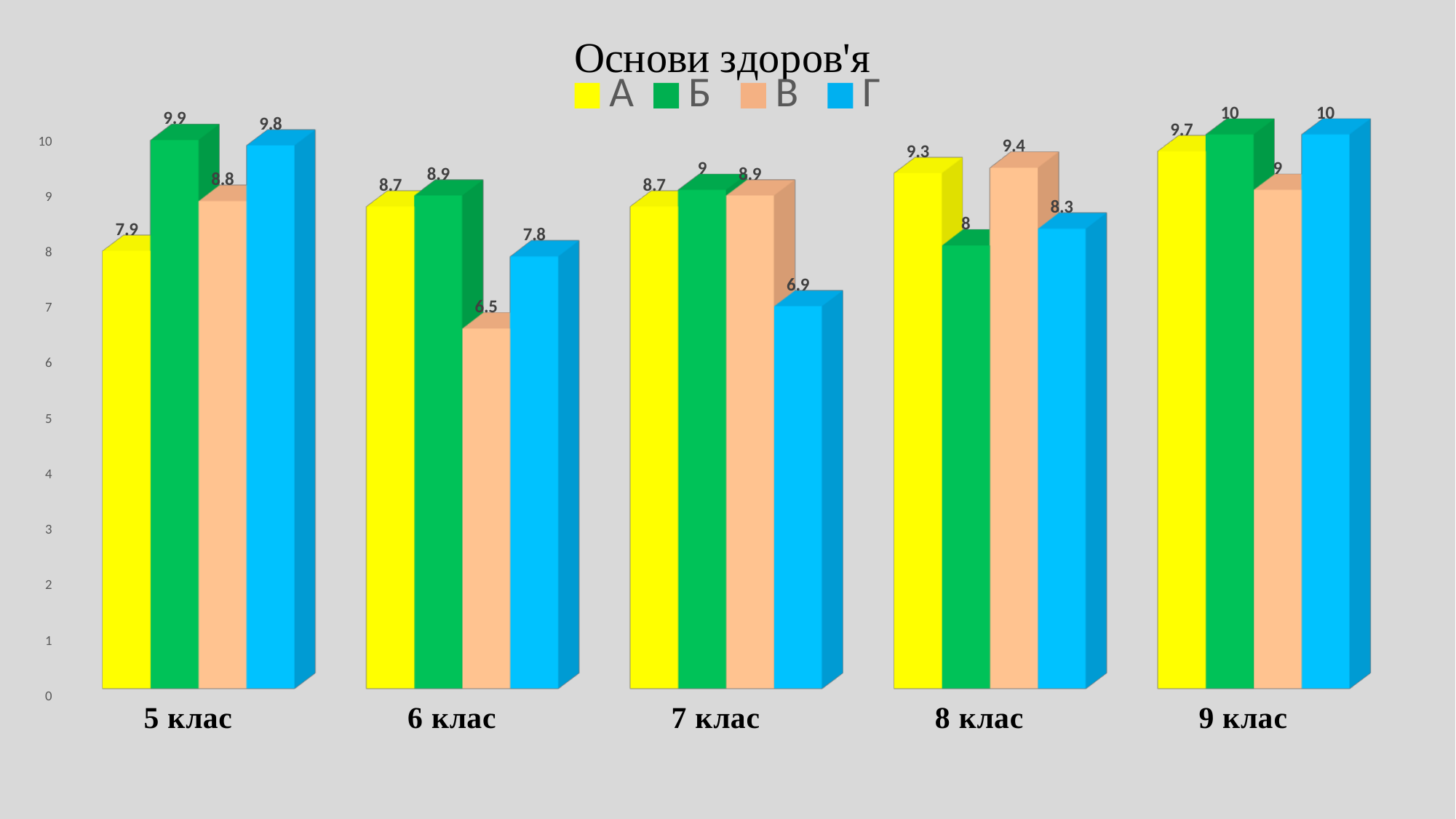
What is the difference between series Г in 5 клас and series Г in 6 клас? 2 What is the title of the chart? Основи здоров'я What is the difference between series Б and series В in 6 клас? 2.4 What is the value for series В in 6 клас? 6.5 Which series has the lowest value in 8 клас? Б What is the value for series А in 8 клас? 9.3 Which series has the highest value in 5 клас? Б How many categories (classes) are shown on the x axis? 5 How many series does the legend list? 4 Which is larger: series А in 9 клас or series А in 5 клас? 9 клас What kind of chart is shown on the slide? Bar chart What is the value for series Г in 7 клас? 6.9